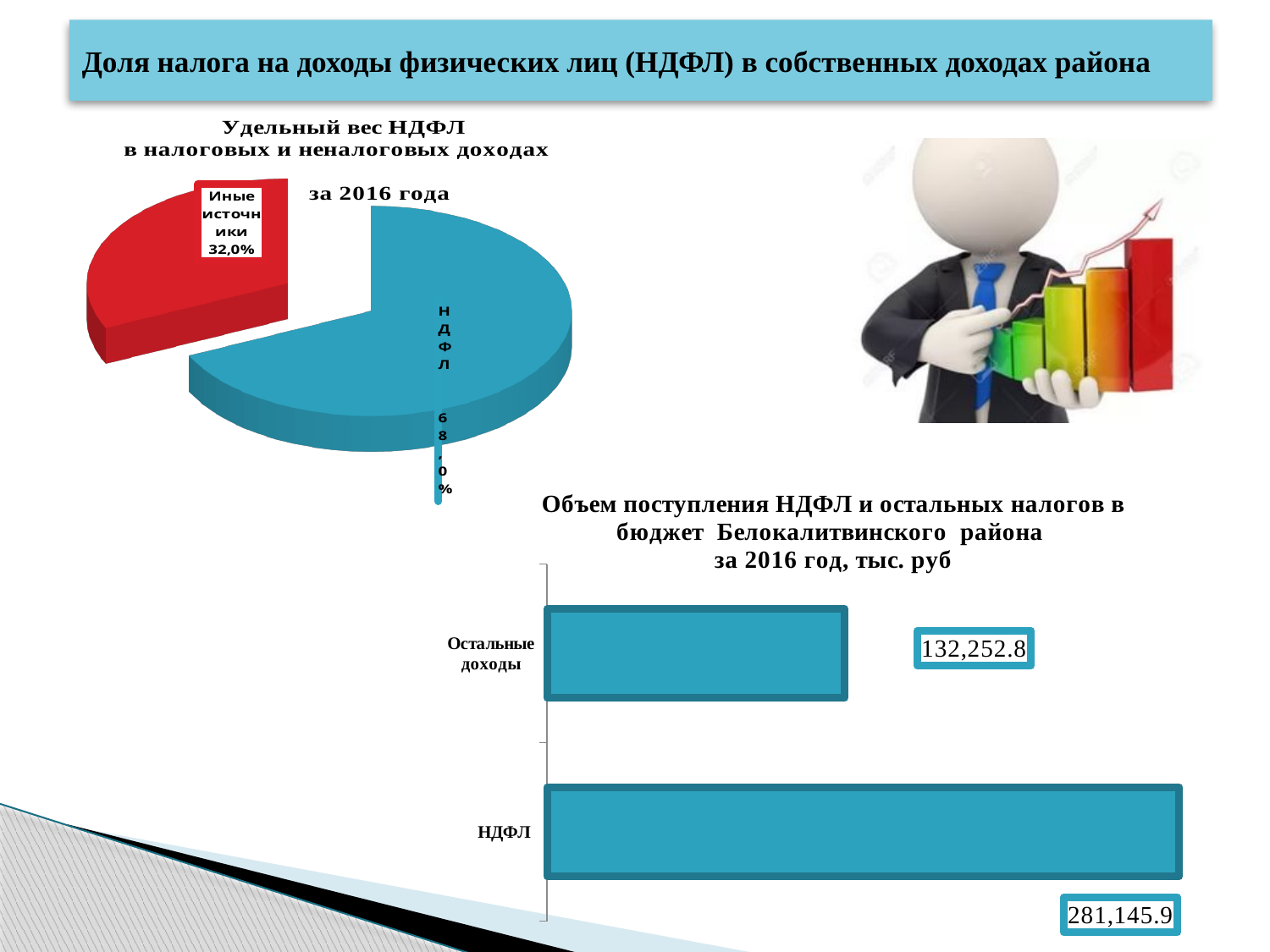
In the chart 'Объем поступления НДФЛ и остальных налогов в бюджет Белокалитвинского района за 2016 год, тыс. руб', what is the value for 'Остальные доходы'? 132,252.8 In the chart 'Объем поступления НДФЛ и остальных налогов в бюджет Белокалитвинского района за 2016 год, тыс. руб', which category has the higher value? НДФЛ In the chart 'Объем поступления НДФЛ и остальных налогов в бюджет Белокалитвинского района за 2016 год, тыс. руб', what is the difference between НДФЛ and 'Остальные доходы'? 148,893.1 What type of chart is the chart in the upper left of the slide? Pie chart In the pie chart 'Удельный вес НДФЛ в налоговых и неналоговых доходах за 2016 года', which slice is the largest? НДФЛ In the pie chart 'Удельный вес НДФЛ в налоговых и неналоговых доходах за 2016 года', what colour is the НДФЛ slice? Blue In the pie chart 'Удельный вес НДФЛ в налоговых и неналоговых доходах за 2016 года', what share do 'Иные источники' have? 32,0% In the chart 'Объем поступления НДФЛ и остальных налогов в бюджет Белокалитвинского района за 2016 год, тыс. руб', what is the value for НДФЛ? 281,145.9 How many categories are shown in the chart 'Объем поступления НДФЛ и остальных налогов в бюджет Белокалитвинского района за 2016 год, тыс. руб'? 2 What type of chart is the chart 'Объем поступления НДФЛ и остальных налогов в бюджет Белокалитвинского района за 2016 год, тыс. руб'? Bar chart How many slices does the pie chart 'Удельный вес НДФЛ в налоговых и неналоговых доходах за 2016 года' have? 2 In the pie chart 'Удельный вес НДФЛ в налоговых и неналоговых доходах за 2016 года', what share does НДФЛ have? 68,0%